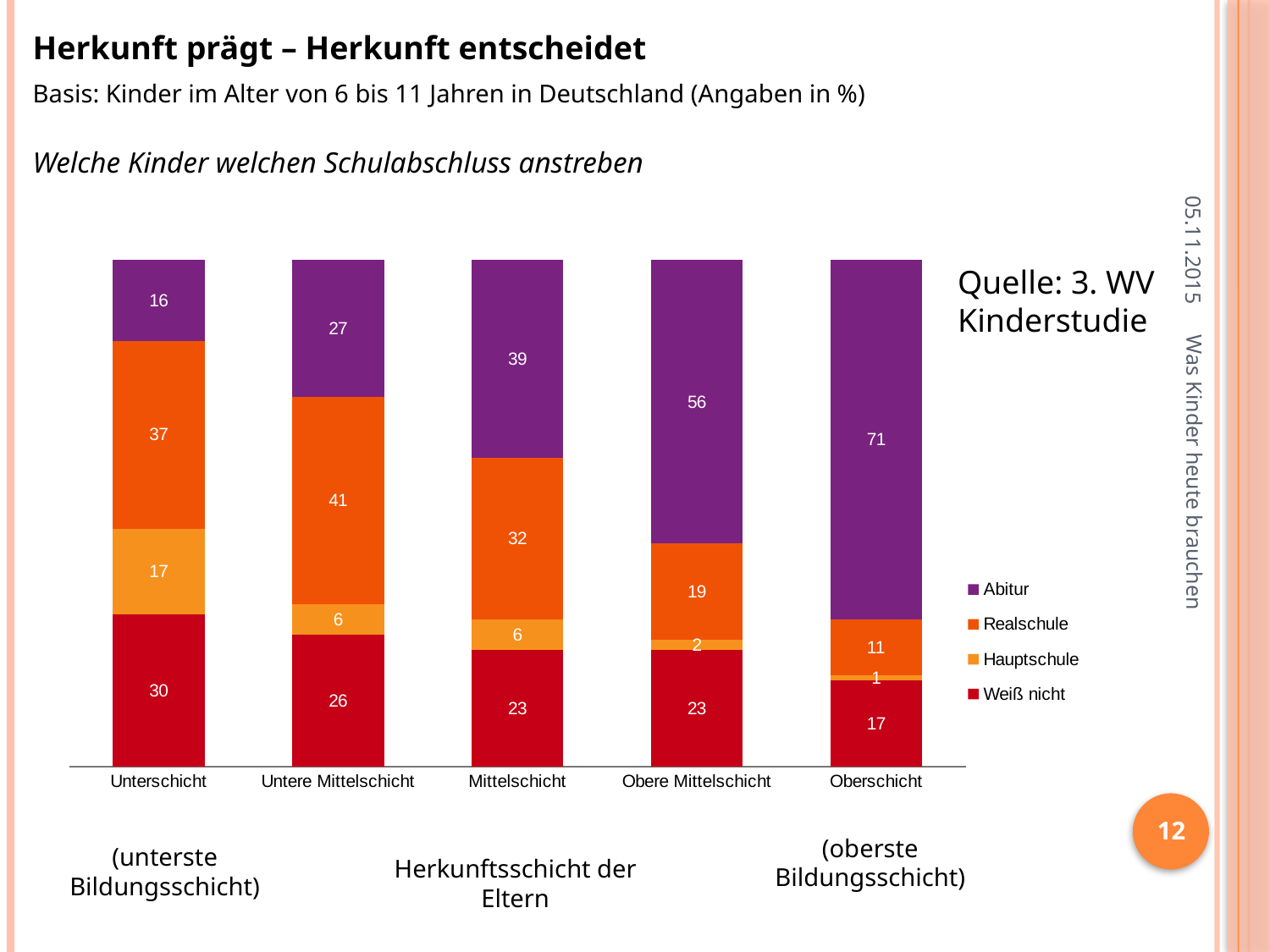
What is the Realschule value for Untere Mittelschicht? 41 What is the Hauptschule value for Obere Mittelschicht? 2 Which category has the highest Abitur value? Oberschicht What is the total of the stacked bar for Mittelschicht? 100 How many series does the legend list? 4 What is the difference between the Abitur values for Oberschicht and Unterschicht? 55 Which is larger, the Realschule value for Mittelschicht or the Realschule value for Obere Mittelschicht? Mittelschicht How many categories are shown on the x axis? 5 Which category has the lowest Hauptschule value? Oberschicht What kind of chart is shown on the slide? Stacked bar chart What is the Abitur value for Oberschicht? 71 What is the Weiß nicht value for Unterschicht? 30